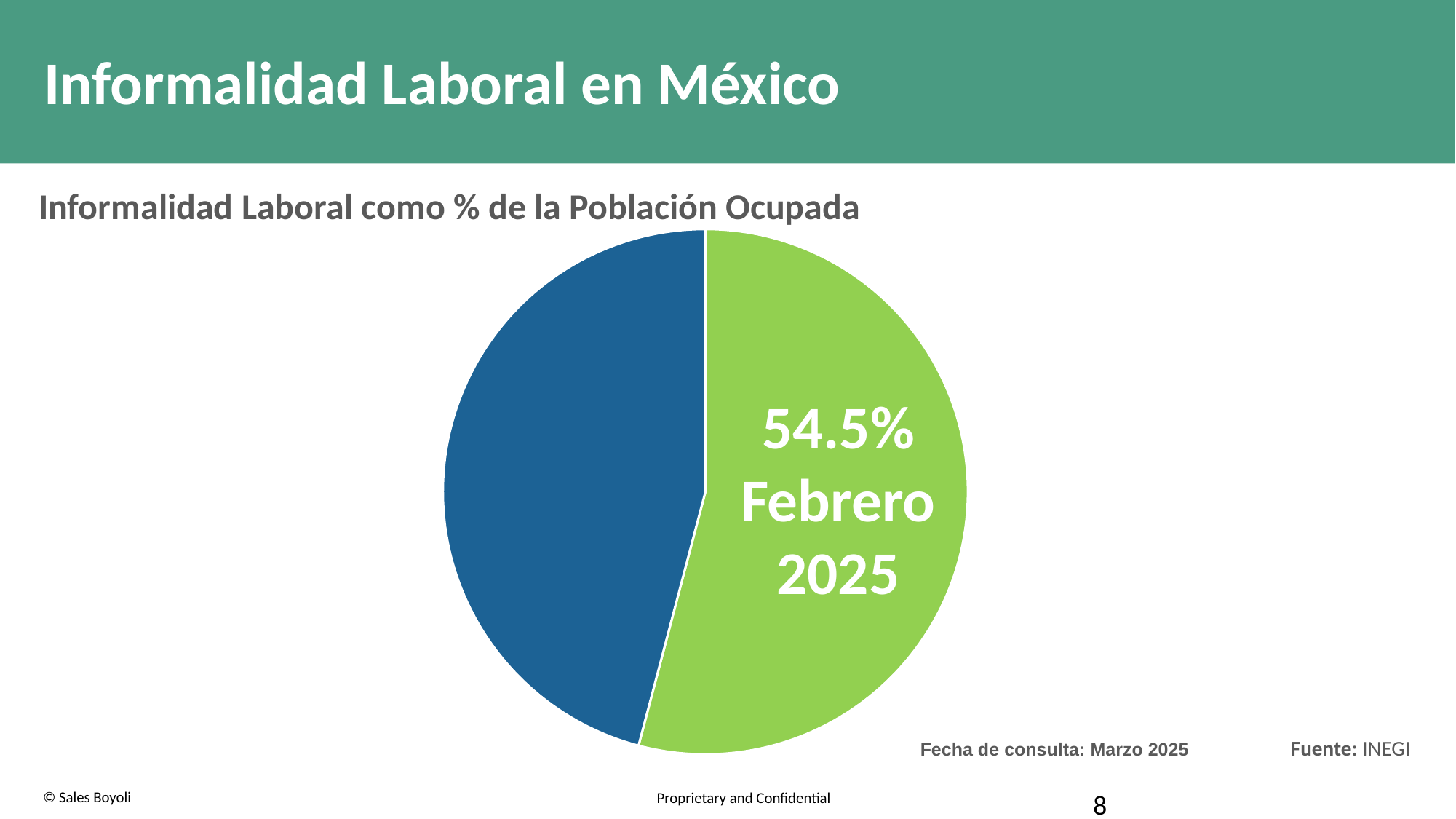
What colour is the slice that carries the 54.5% label? green Which slice of the pie chart is the largest? the green slice (54.5%) Is the share of the blue slice greater or less than 50%? less What is the title of the chart? Informalidad Laboral como % de la Población Ocupada How many slices does the pie chart have? 2 What kind of chart is shown on the slide? pie chart What value is printed on the green slice of the pie chart? 54.5% Which slice of the pie chart is the smallest? the blue slice Which slice of the pie chart is larger, the green one or the blue one? the green one Is the share of the green slice greater or less than 50%? greater Which month and year does the data label on the pie chart refer to? Febrero 2025